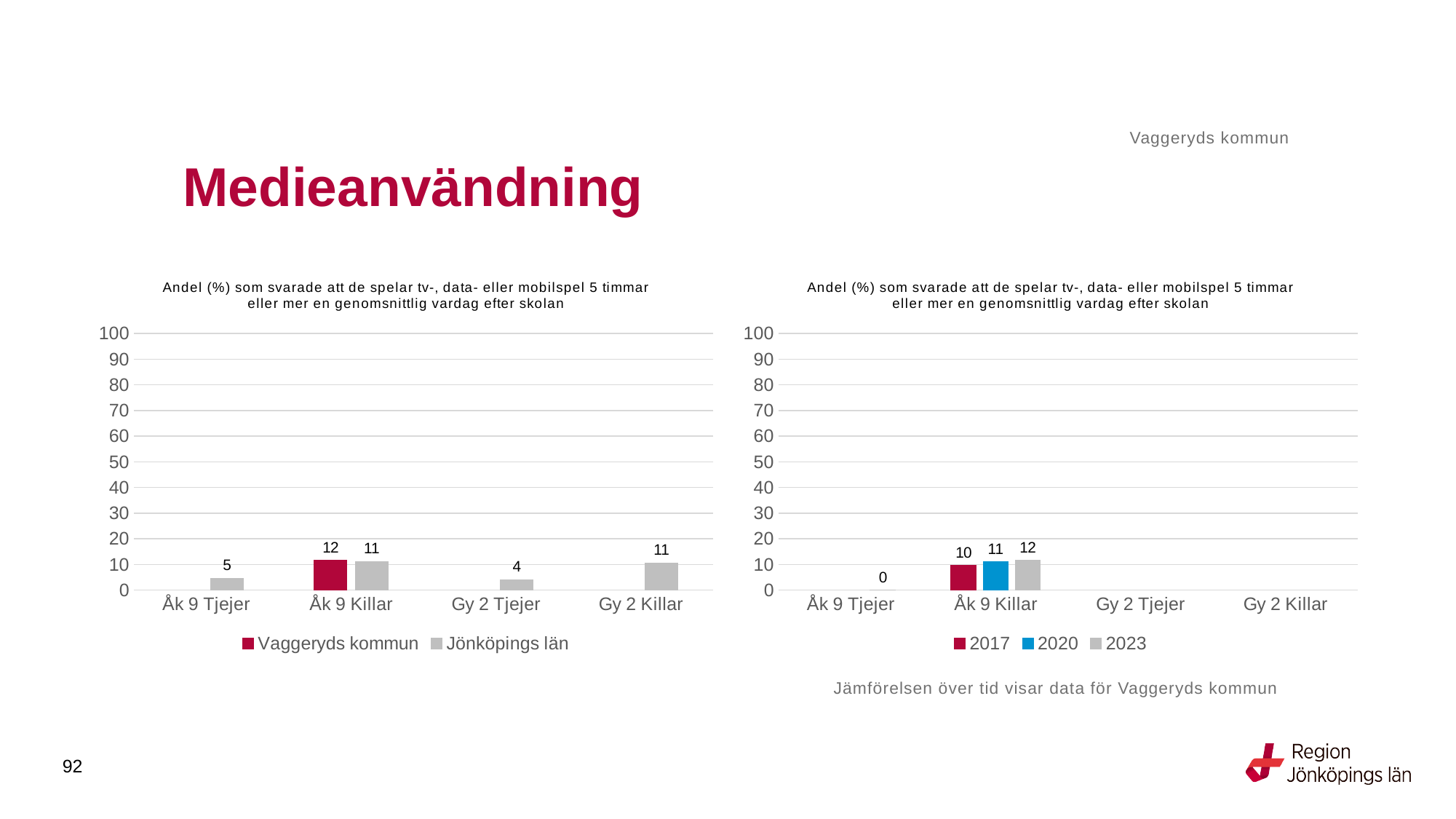
In the right chart, how many series does the legend list? 3 In the left chart, what is the value for Jönköpings län for Gy 2 Tjejer? 4 In the left chart, what is the difference between Vaggeryds kommun and Jönköpings län for Åk 9 Killar? 1 In the right chart, what is the value for 2017 for Åk 9 Killar? 10 In the left chart, which category has the lowest value for Jönköpings län? Gy 2 Tjejer In the right chart, what is the difference between the 2023 and 2017 values for Åk 9 Killar? 2 In the right chart, what is the value for 2023 for Åk 9 Killar? 12 What type of chart is the left chart? Bar chart In the left chart, what is the value for Jönköpings län for Åk 9 Tjejer? 5 In the right chart, which year has the highest value for Åk 9 Killar? 2023 In the left chart, what is the value for Vaggeryds kommun for Åk 9 Killar? 12 In the left chart, how many series does the legend list? 2